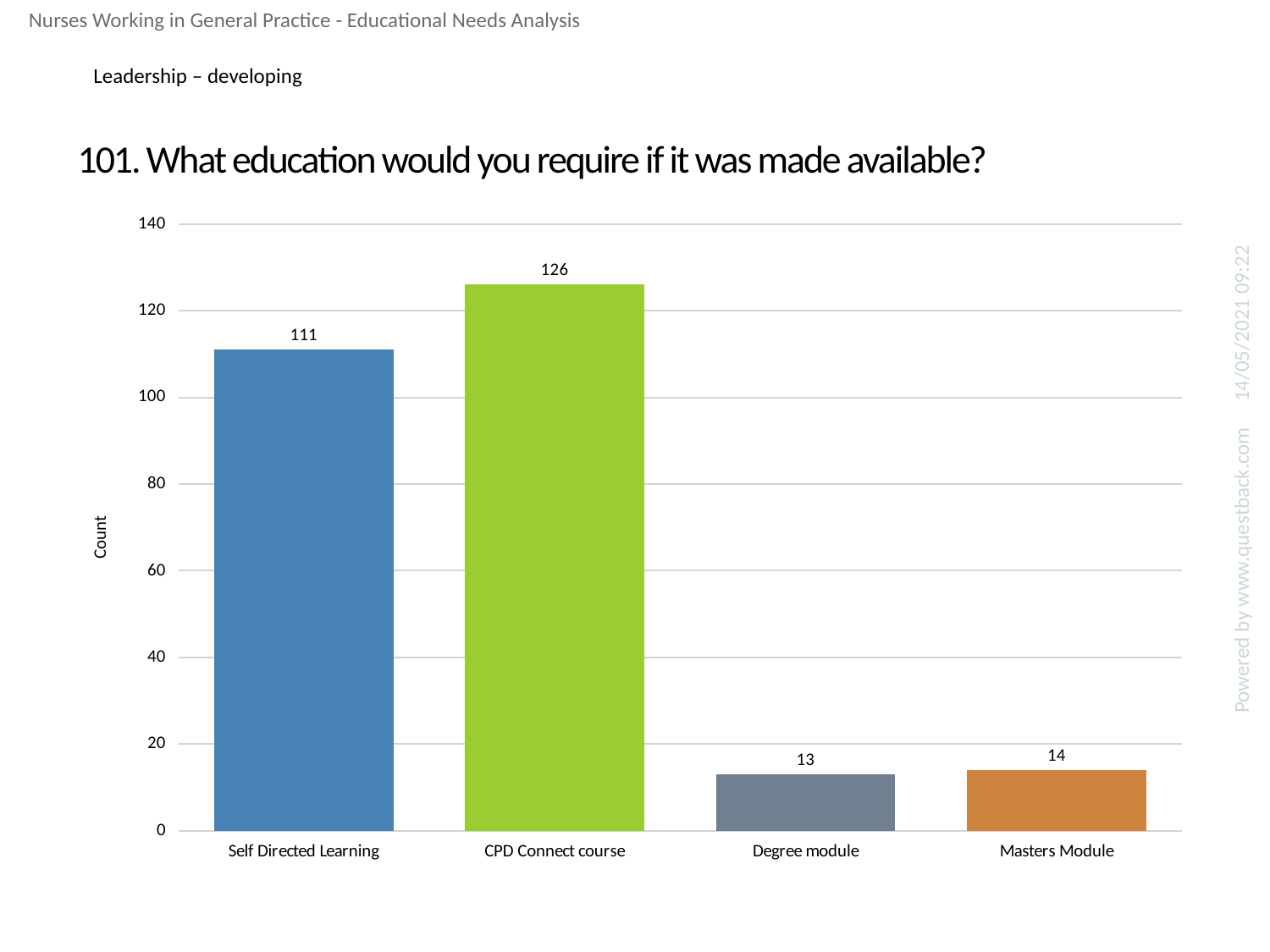
What is the count for CPD Connect course? 126 Is the value for CPD Connect course greater or less than 120? greater Which category has the lowest count? Degree module Which category has the highest count? CPD Connect course Which has a larger count, Self Directed Learning or Degree module? Self Directed Learning What is the difference between the counts for CPD Connect course and Self Directed Learning? 15 What is the count for Masters Module? 14 What is the count for Degree module? 13 What kind of chart is shown on the slide? Bar chart How many categories are shown on the x axis? 4 What is the count for Self Directed Learning? 111 What is the difference between the counts for Masters Module and Degree module? 1